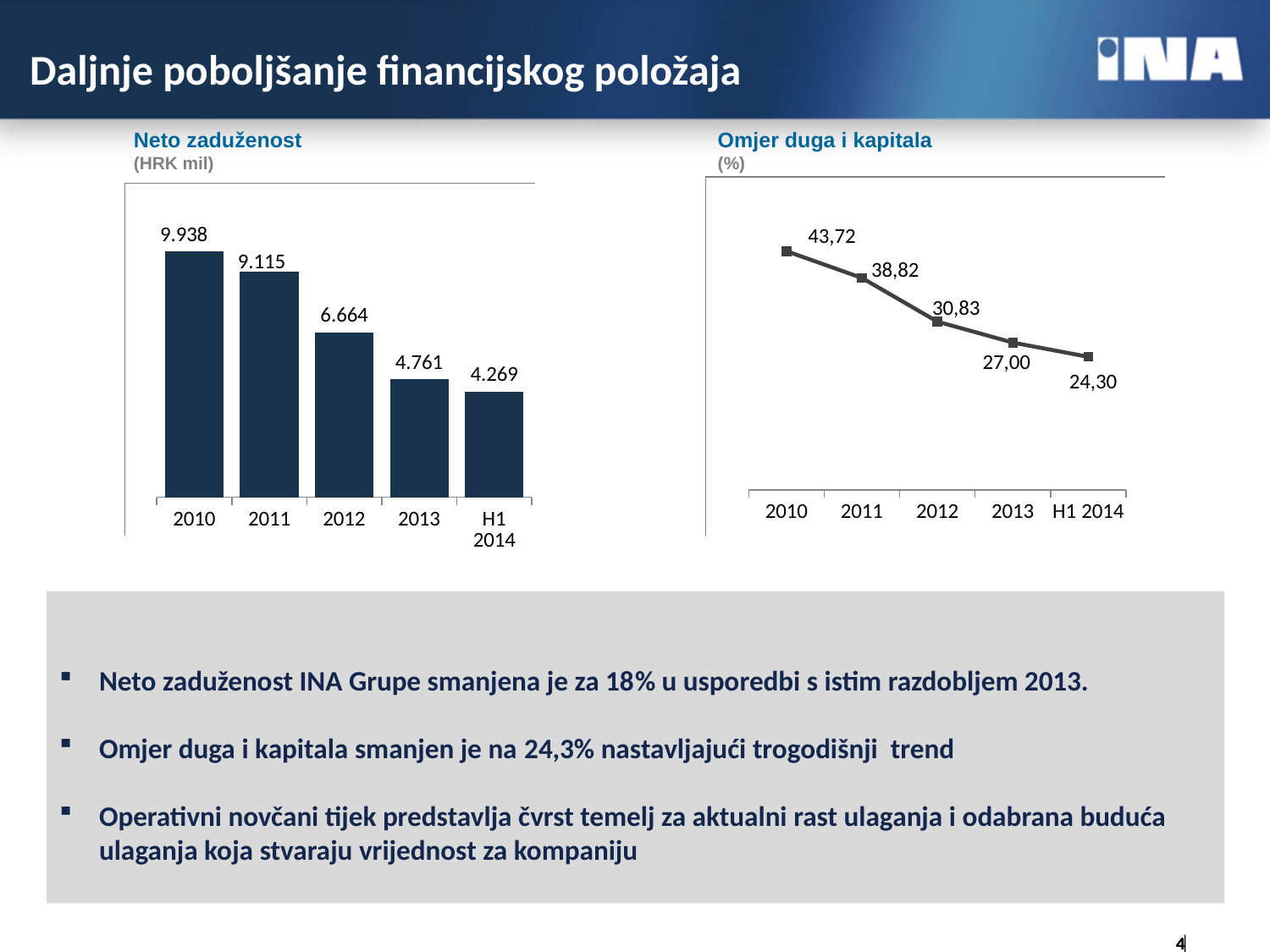
In the 'Omjer duga i kapitala' chart, which category has the highest value? 2010 In the 'Neto zaduženost' chart, how many bars are plotted? 5 In the 'Omjer duga i kapitala' chart, what is the difference between the 2010 and H1 2014 values? 19,42 In the 'Omjer duga i kapitala' chart, do the values rise or fall from 2010 to H1 2014? fall What unit is shown under the title of the 'Neto zaduženost' chart? HRK mil What kind of chart is the 'Neto zaduženost' chart? bar chart In the 'Neto zaduženost' chart, what is the difference between the 2012 and 2013 values? 1.903 In the 'Neto zaduženost' chart, which category has the lowest value? H1 2014 In the 'Omjer duga i kapitala' chart, what is the value for 2013? 27,00 In the 'Neto zaduženost' chart, what is the value for 2010? 9.938 In the 'Omjer duga i kapitala' chart, what is the value for 2011? 38,82 In the 'Neto zaduženost' chart, what is the value for H1 2014? 4.269